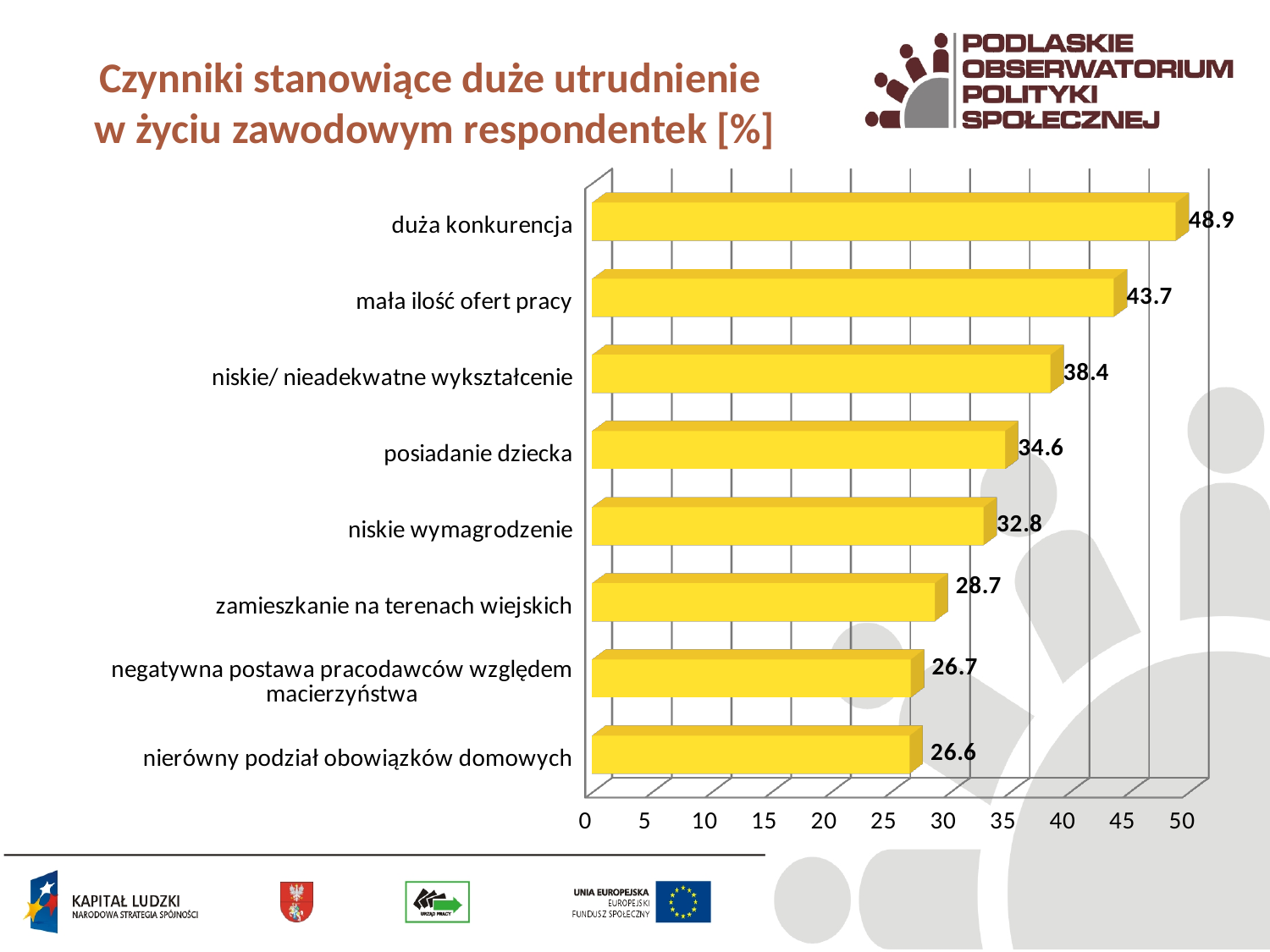
What is the value for "nierówny podział obowiązków domowych"? 26.6 What is the difference between the values for "duża konkurencja" and "mała ilość ofert pracy"? 5.2 How many categories are shown in the chart? 8 What is the difference between the values for "posiadanie dziecka" and "niskie wymagrodzenie"? 1.8 What is the value for "posiadanie dziecka"? 34.6 Which category has the highest value? duża konkurencja Is the value for "mała ilość ofert pracy" greater or less than 40? greater Which category has the lowest value? nierówny podział obowiązków domowych Which is larger: the value for "niskie/ nieadekwatne wykształcenie" or the value for "niskie wymagrodzenie"? niskie/ nieadekwatne wykształcenie What is the value for "zamieszkanie na terenach wiejskich"? 28.7 What is the value for "duża konkurencja"? 48.9 What kind of chart is shown on the slide? bar chart